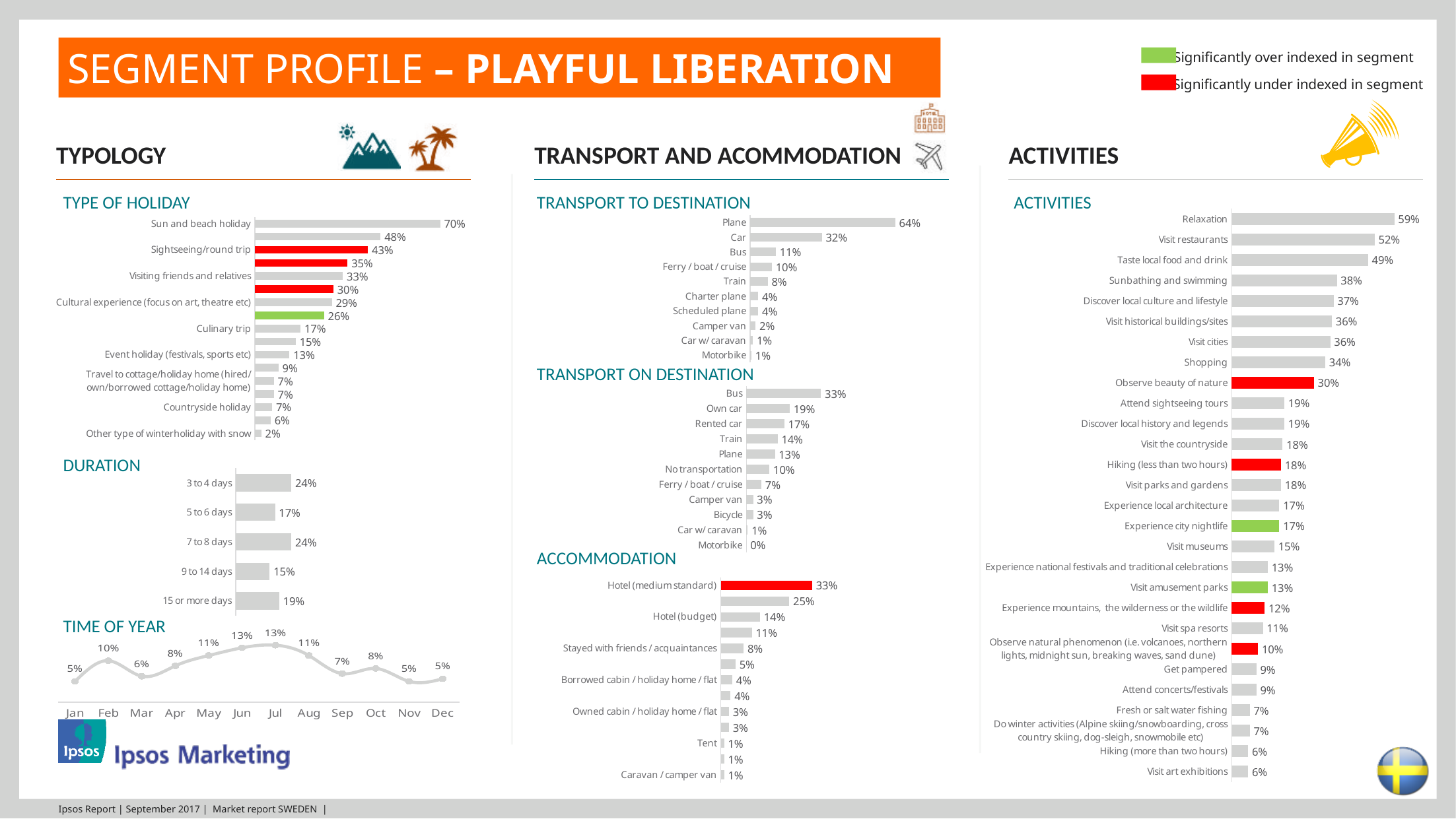
In the Time of Year chart, what is the value for Jun? 13% In the Type of Holiday chart, what percentage is shown for Sun and beach holiday? 70% In the Duration chart, which category has the lowest value? 9 to 14 days In the Accommodation chart, what percentage is shown for Hotel (medium standard)? 33% In the Transport to Destination chart, what percentage is shown for Plane? 64% In the Activities chart, what percentage is shown for Relaxation? 59% In the Duration chart, how many categories are shown? 5 In the Transport on Destination chart, what percentage is shown for Motorbike? 0% What kind of chart is the Time of Year chart? Line chart In the Activities chart, what is the difference between Visit restaurants and Taste local food and drink? 3% In the Transport on Destination chart, what is the difference between Bus and Own car? 14% In the Transport to Destination chart, which is larger, Car or Bus? Car